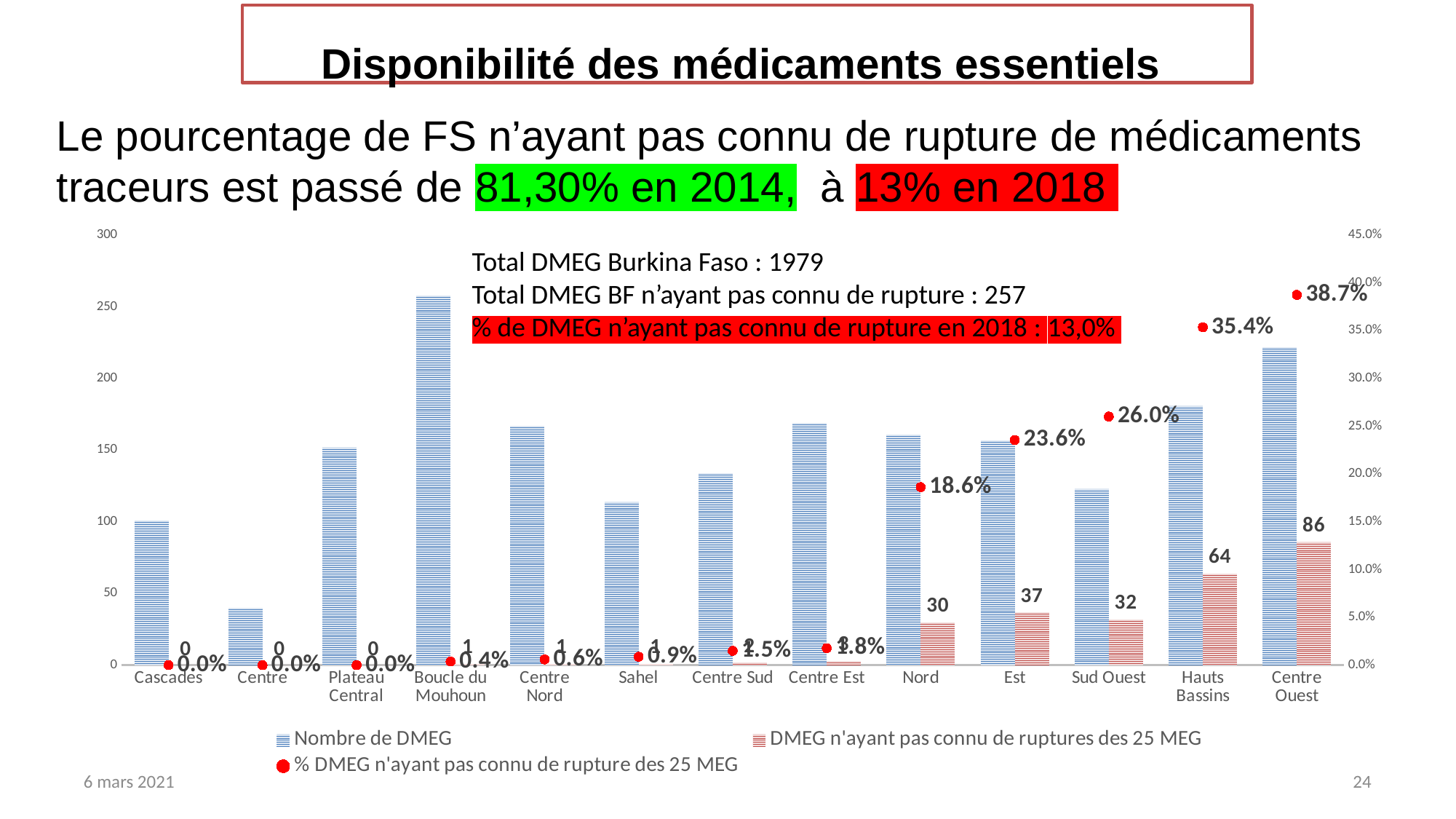
What is the '% DMEG n'ayant pas connu de rupture des 25 MEG' for Nord? 18.6% What is the '% DMEG n'ayant pas connu de rupture des 25 MEG' for Hauts Bassins? 35.4% What is the difference between the 'DMEG n'ayant pas connu de ruptures des 25 MEG' values for Centre Ouest and Hauts Bassins? 22 Which region has the highest number of 'DMEG n'ayant pas connu de ruptures des 25 MEG'? Centre Ouest How many series does the chart legend list? 3 Is the 'Nombre de DMEG' for Centre greater or less than 50? less Which region has the highest '% DMEG n'ayant pas connu de rupture des 25 MEG'? Centre Ouest Is the 'Nombre de DMEG' for Boucle du Mouhoun greater or less than 250? greater Which has more 'DMEG n'ayant pas connu de ruptures des 25 MEG': Est or Sud Ouest? Est What kind of chart is shown on the slide? bar chart with a line of percentage markers (combo chart) What is the value of 'DMEG n'ayant pas connu de ruptures des 25 MEG' for Centre Ouest? 86 How many regions are shown on the x axis of the chart? 13